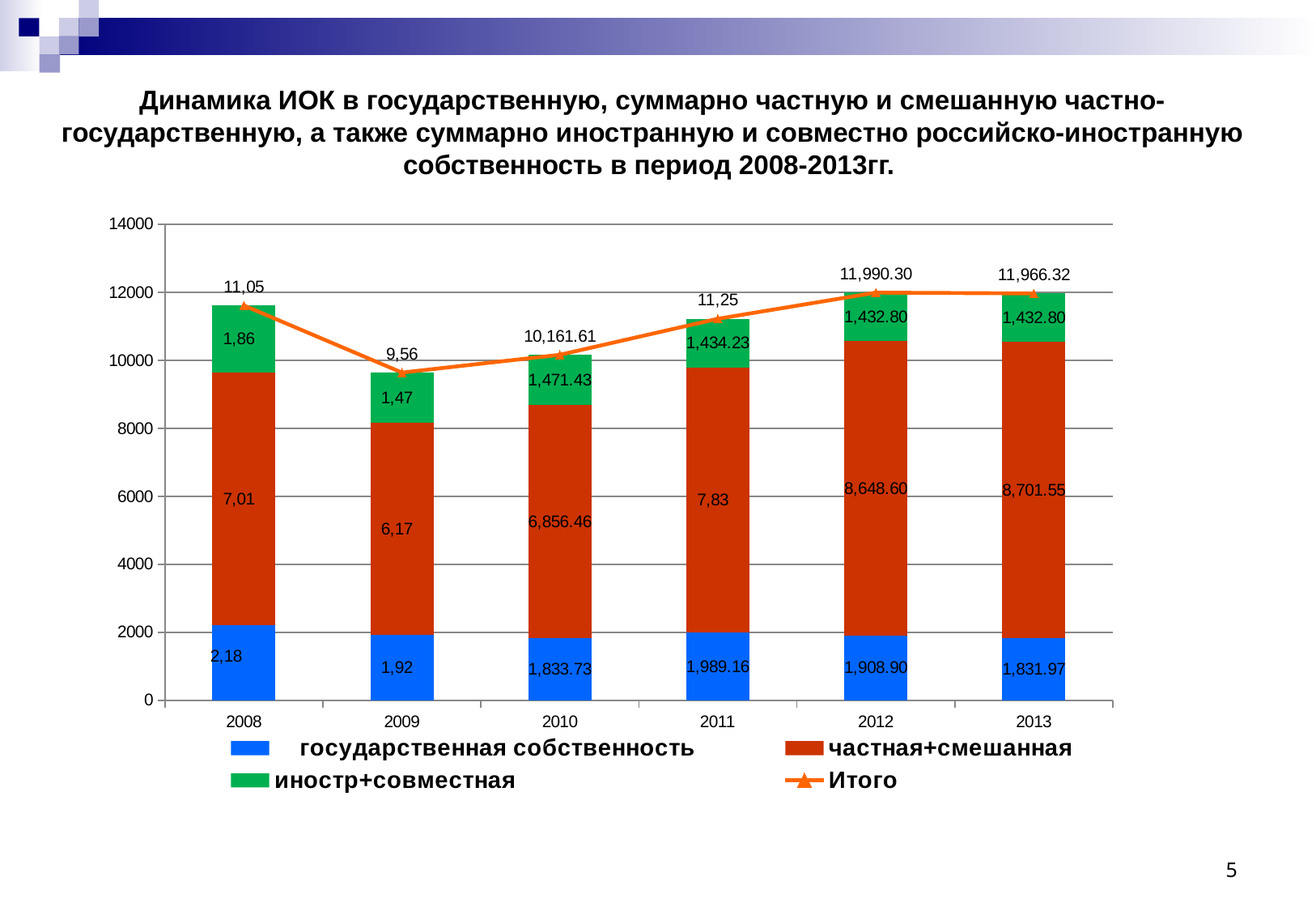
What is the value labelled for частная+смешанная in 2010? 6,856.46 Which year has the larger государственная собственность value, 2011 or 2012? 2011 What kind of chart is shown on the slide? Stacked bar chart with a line What is the value labelled for государственная собственность in 2013? 1,831.97 What is the value labelled for иностр+совместная in 2011? 1,434.23 Does the Итого line rise or fall from 2009 to 2012? Rise How many series does the legend list? 4 What is the difference between the частная+смешанная values for 2013 and 2012? 52.95 How many years are shown on the x axis? 6 In which year is the Итого value the lowest? 2009 In which year is the Итого value the highest? 2012 What is the value of the Итого line for 2012? 11,990.30